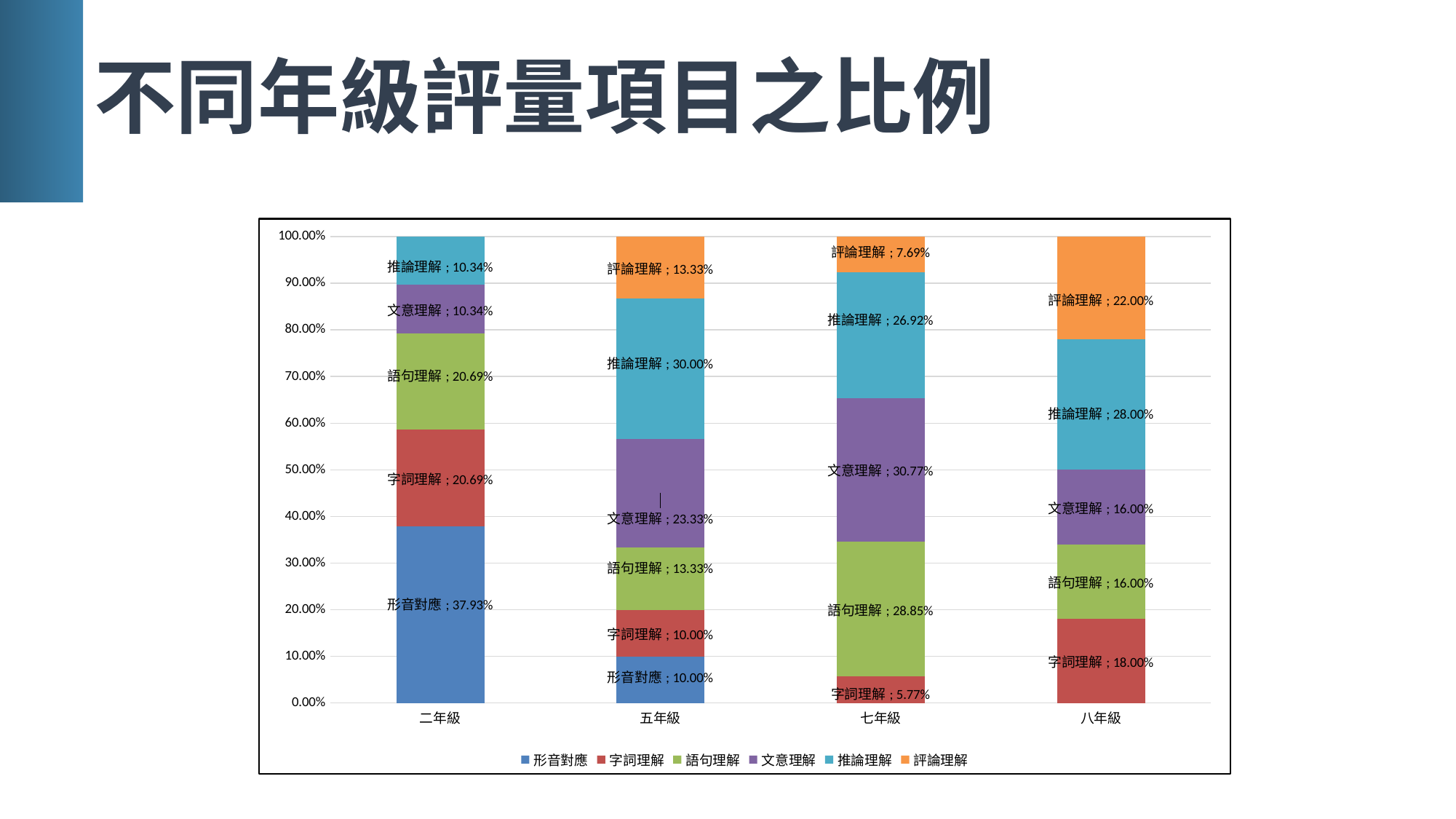
What is the value for 評論理解 in 八年級? 22.00% Which is larger: 評論理解 in 五年級 or 評論理解 in 七年級? 評論理解 in 五年級 What is the title of the slide? 不同年級評量項目之比例 What kind of chart is shown on the slide? Stacked bar chart What is the value for 形音對應 in 二年級? 37.93% How many grade categories are shown on the x axis? 4 How many series does the legend list? 6 Which grade has the highest value for 推論理解? 五年級 What is the value for 文意理解 in 七年級? 30.77% What is the value for 推論理解 in 五年級? 30.00% Which grade has the lowest value for 字詞理解? 七年級 What is the difference between 文意理解 in 七年級 and 文意理解 in 八年級? 14.77%